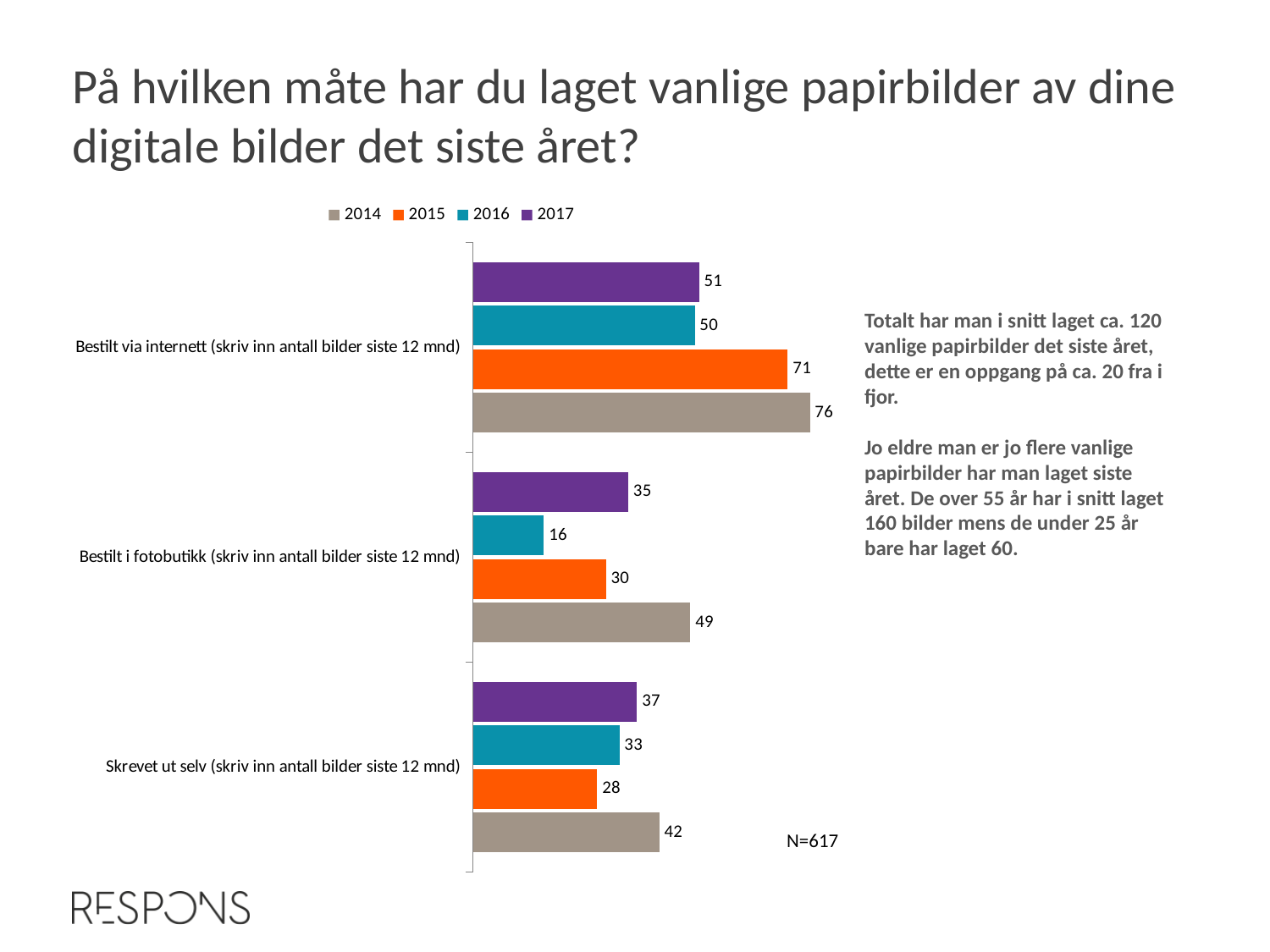
What is the 2017 value for "Bestilt via internett (skriv inn antall bilder siste 12 mnd)"? 51 Which year is shown in orange in the legend? 2015 Which category has the lowest 2016 value? Bestilt i fotobutikk (skriv inn antall bilder siste 12 mnd) How many categories are shown on the chart? 3 What is the 2016 value for "Bestilt i fotobutikk (skriv inn antall bilder siste 12 mnd)"? 16 What is the 2014 value for "Skrevet ut selv (skriv inn antall bilder siste 12 mnd)"? 42 Which is larger for "Skrevet ut selv (skriv inn antall bilder siste 12 mnd)": the 2016 value or the 2015 value? 2016 How many series does the legend list? 4 Which category has the highest 2015 value? Bestilt via internett (skriv inn antall bilder siste 12 mnd) What is the difference between the 2014 and 2017 values for "Bestilt via internett (skriv inn antall bilder siste 12 mnd)"? 25 What kind of chart is shown on the slide? Bar chart What is the sample size (N) shown on the slide? N=617